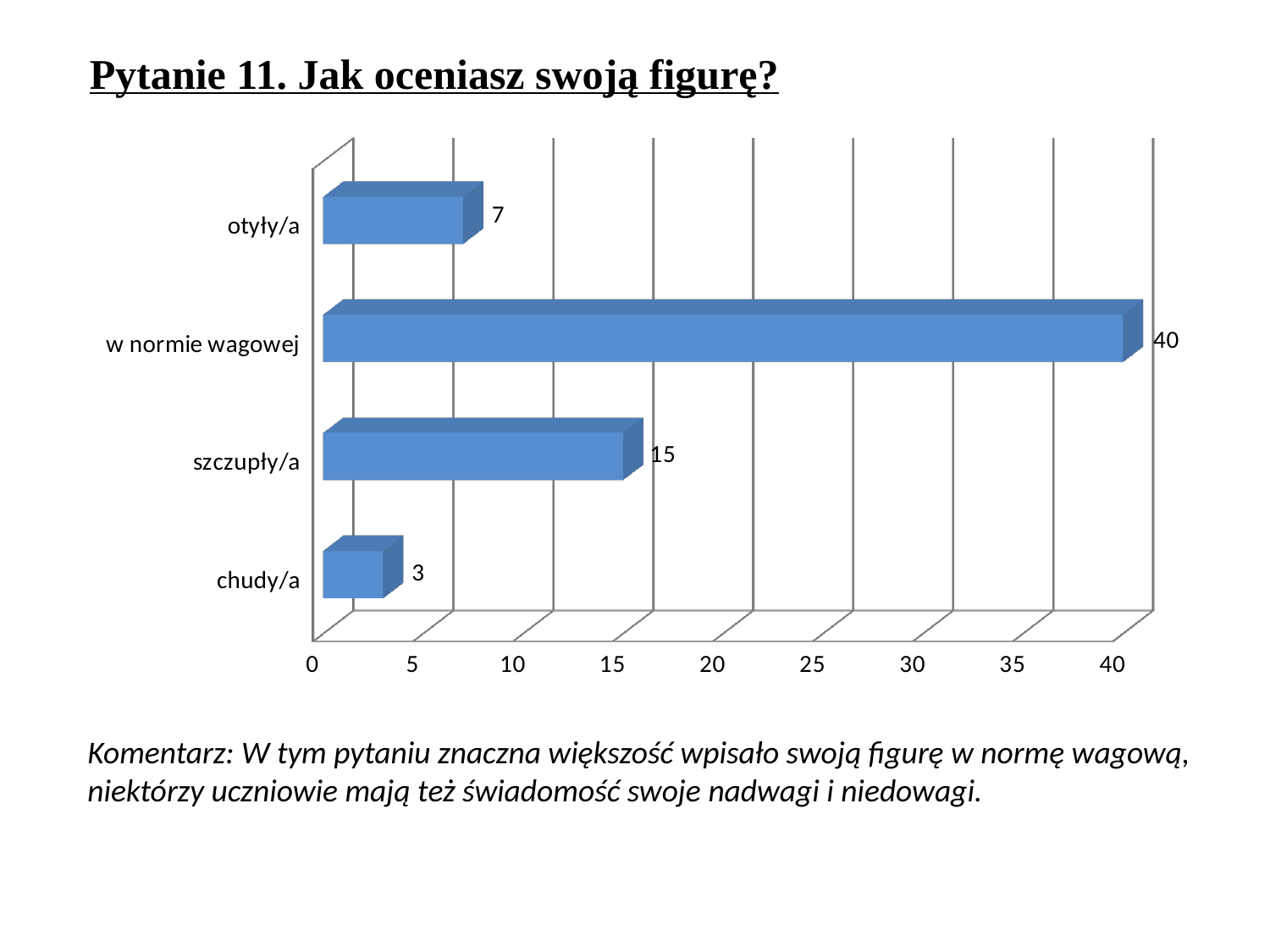
Is the value for "szczupły/a" greater or less than 10? greater What is the difference between the values for "otyły/a" and "chudy/a"? 4 What is the difference between the values for "w normie wagowej" and "szczupły/a"? 25 What kind of chart is shown on the slide? bar chart Which category has the highest value? w normie wagowej What is the value for "szczupły/a"? 15 Which is larger, the value for "szczupły/a" or the value for "otyły/a"? szczupły/a What is the value for "w normie wagowej"? 40 Which category has the lowest value? chudy/a What is the value for "otyły/a"? 7 How many categories are shown in the chart? 4 What is the value for "chudy/a"? 3